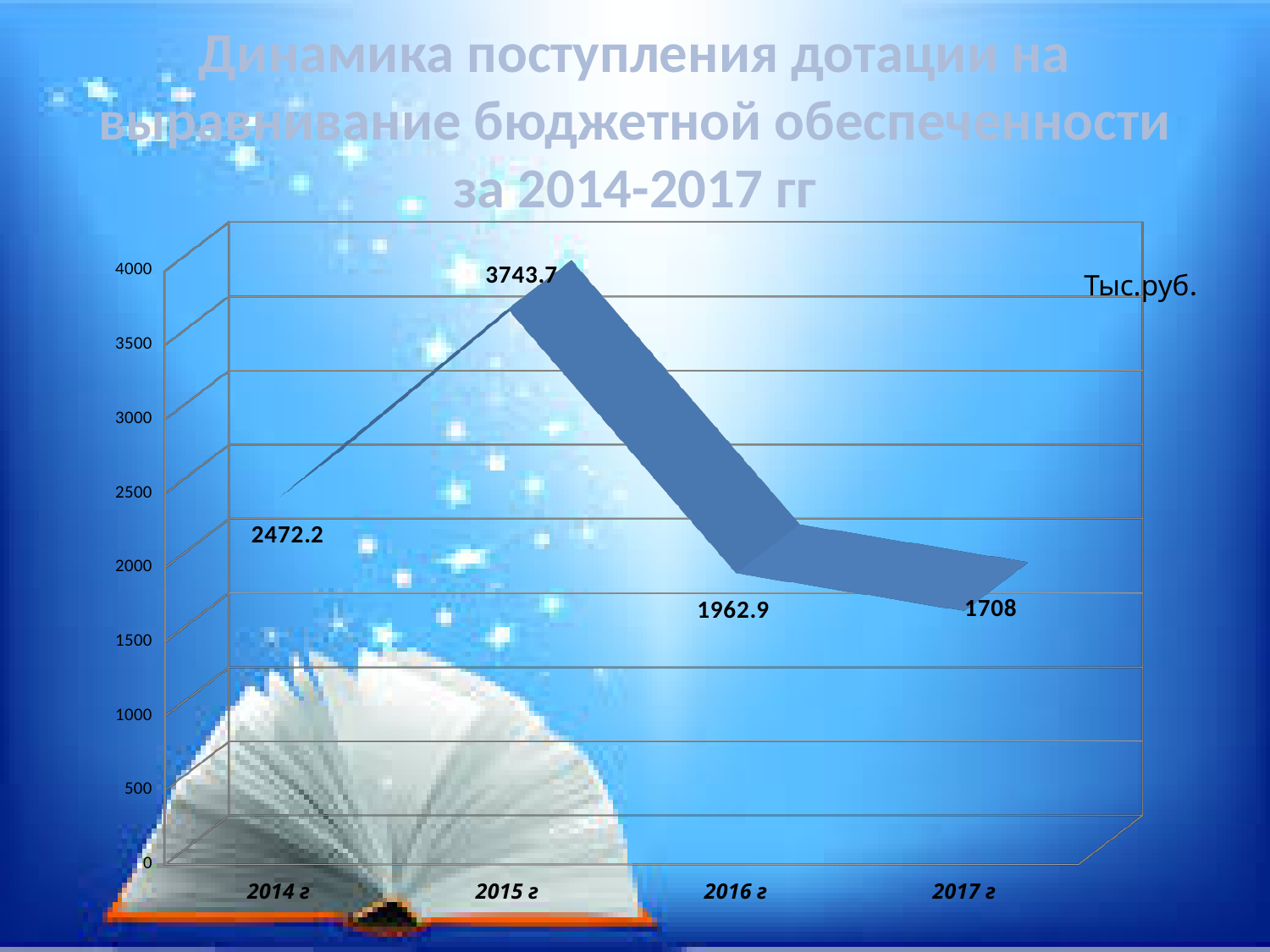
What kind of chart is shown on the slide? line chart What is the value for 2016 г? 1962.9 Which is larger, the value for 2014 г or the value for 2016 г? 2014 г Which year has the highest value? 2015 г What unit of measurement is indicated on the chart? Тыс.руб. What is the difference between the values for 2015 г and 2014 г? 1271.5 What is the difference between the values for 2016 г and 2017 г? 254.9 What is the value for 2015 г? 3743.7 Which year has the lowest value? 2017 г How many years are plotted on the chart? 4 What is the value for 2014 г? 2472.2 What is the value for 2017 г? 1708